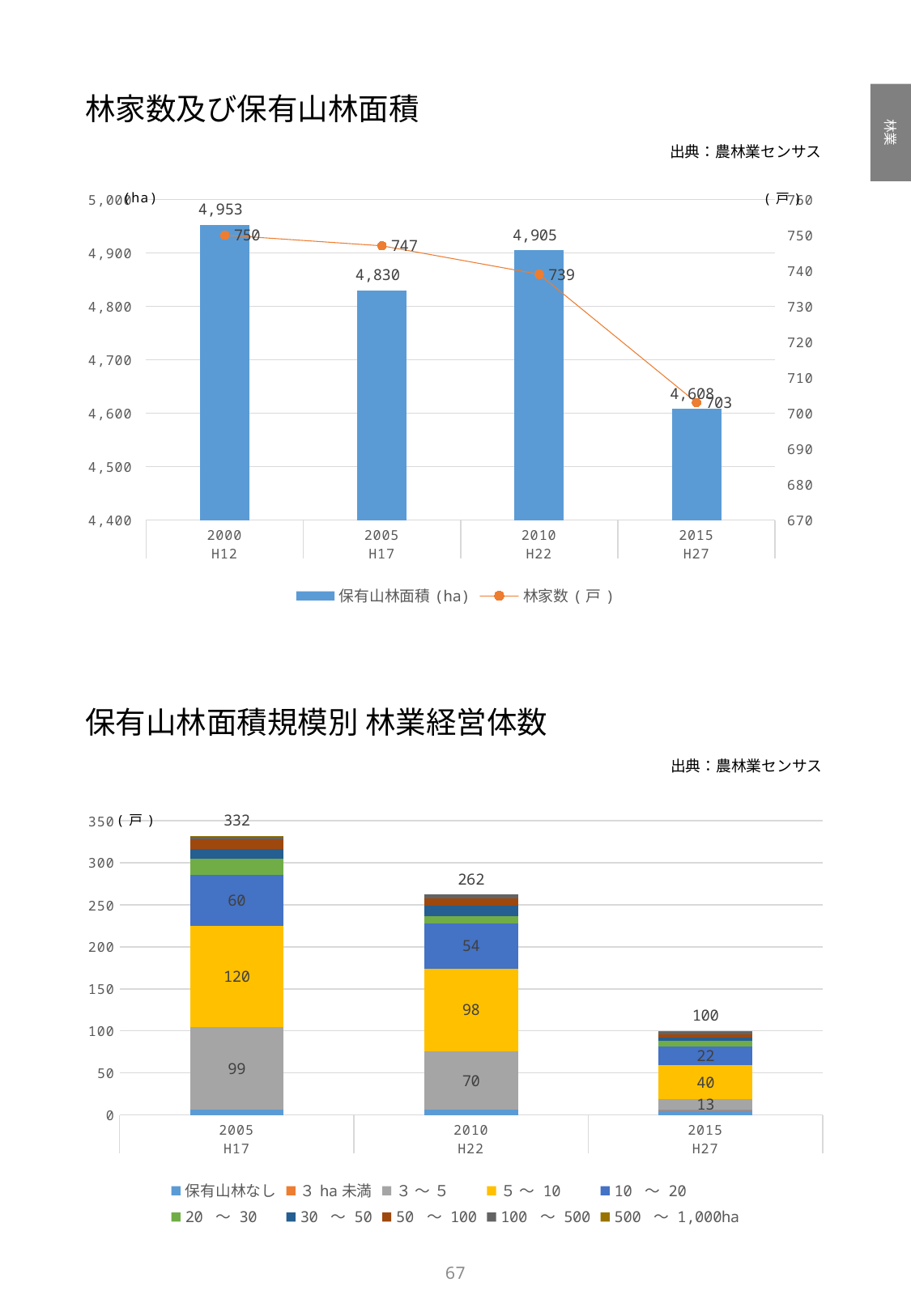
In the chart titled 林家数及び保有山林面積, does 林家数 (戸) rise or fall from 2000 to 2015? fall In the chart titled 林家数及び保有山林面積, what is the value of 林家数 (戸) for 2015 (H27)? 703 In the chart titled 保有山林面積規模別 林業経営体数, how many categories are shown on the x axis? 3 In the chart titled 保有山林面積規模別 林業経営体数, what is the total for the 2010 (H22) bar? 262 In the chart titled 保有山林面積規模別 林業経営体数, which is larger: the 10 ～ 20 segment in 2005 or in 2010? 2005 What kind of chart is the chart titled 保有山林面積規模別 林業経営体数? stacked bar chart In the chart titled 保有山林面積規模別 林業経営体数, what is the value of the 5 ～ 10 segment for 2005 (H17)? 120 In the chart titled 林家数及び保有山林面積, which year has the lowest 保有山林面積 (ha)? 2015 (H27) In the chart titled 林家数及び保有山林面積, how many series does the legend list? 2 In the chart titled 林家数及び保有山林面積, what is the value of 保有山林面積 (ha) for 2000 (H12)? 4,953 In the chart titled 林家数及び保有山林面積, what is the difference in 保有山林面積 (ha) between 2000 and 2015? 345 In the chart titled 保有山林面積規模別 林業経営体数, what is the value of the 3 ～ 5 segment for 2015 (H27)? 13